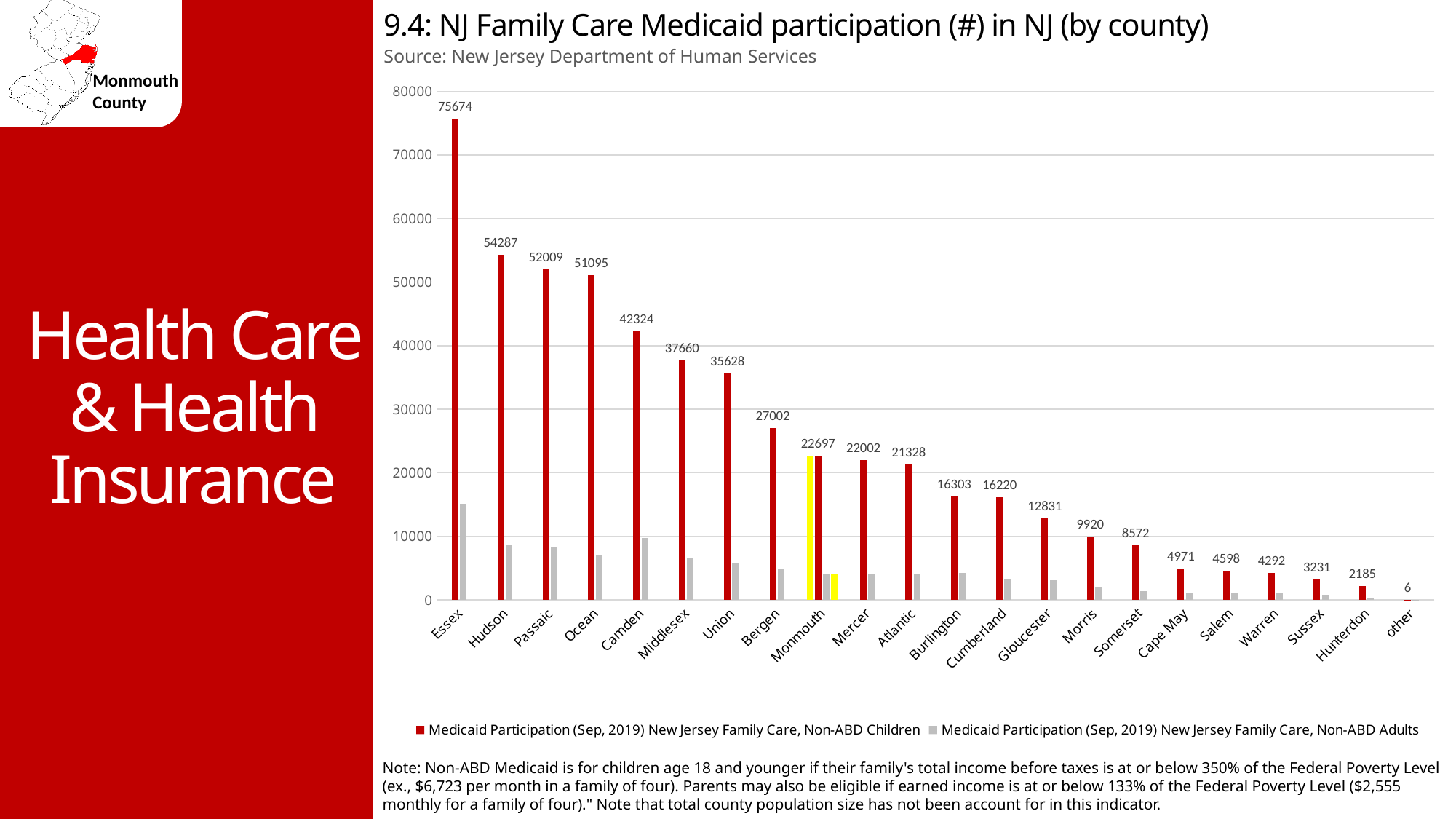
How many categories are shown on the x axis of the chart? 22 Which category has the lowest Non-ABD Children Medicaid participation? other What is the Non-ABD Children Medicaid participation value for Monmouth County? 22697 Do the Non-ABD Children values rise or fall moving from left to right along the x axis? fall Which county has a larger Non-ABD Children value, Camden or Middlesex? Camden How many series does the legend list? 2 Is the Non-ABD Adults value for Essex greater or less than 10000? greater Which county's bars are highlighted in yellow on the chart? Monmouth What kind of chart is shown on the slide? bar chart What is the Non-ABD Children Medicaid participation value for Bergen County? 27002 What is the difference between the Non-ABD Children values for Essex and Hudson? 21387 Which county has the highest Non-ABD Children Medicaid participation? Essex